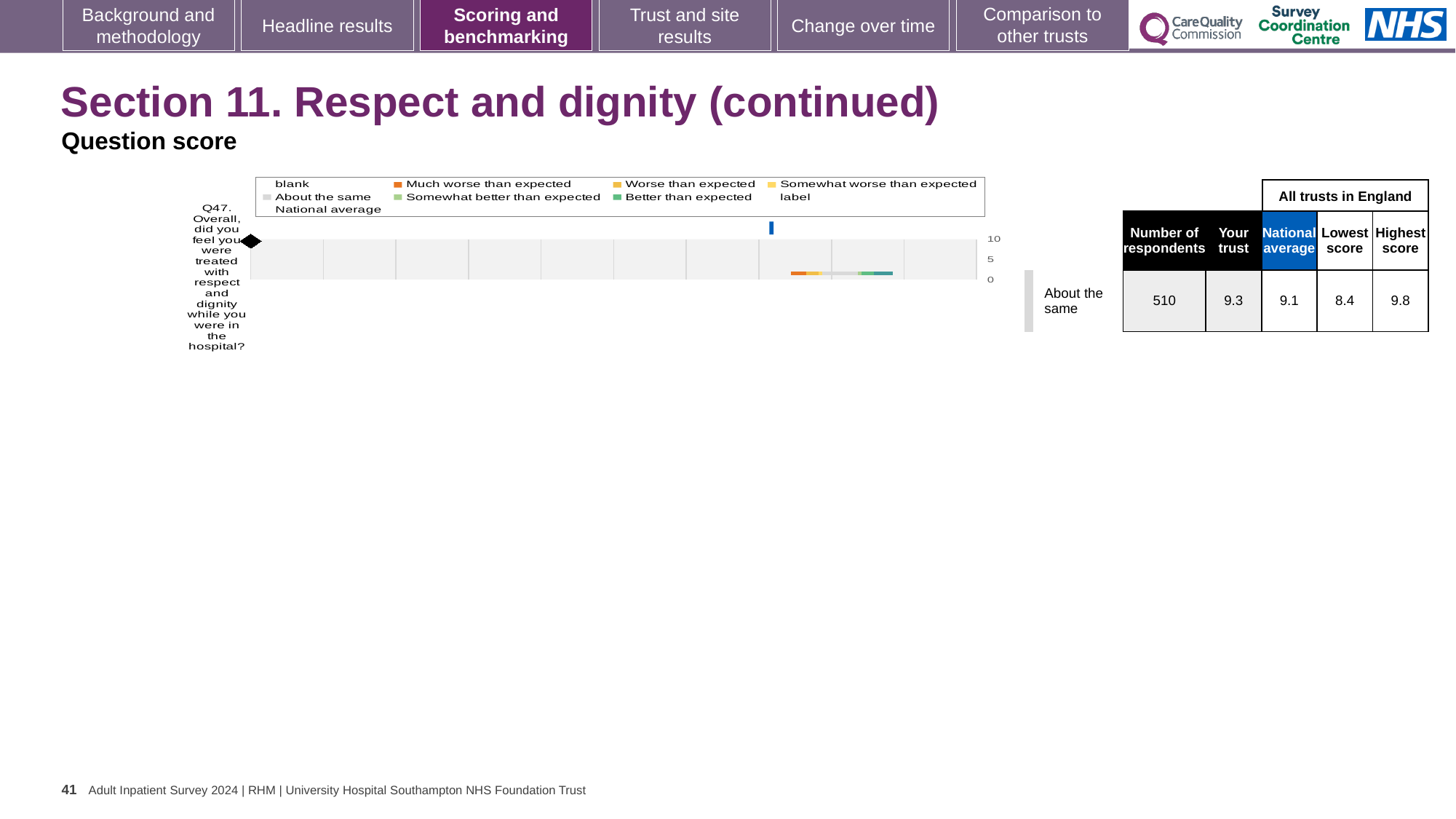
What is the highest score among all trusts in England for Q47? 9.8 How many questions (categories) are plotted on the chart? 1 What is the number of respondents for Q47? 510 What kind of chart is shown on the slide? bar chart Which is larger for Q47, the 'Your trust' score or the national average? Your trust What is the national average score for Q47? 9.1 What is the 'Your trust' score for Q47? 9.3 What is the difference between the highest score and the lowest score among all trusts in England for Q47? 1.4 Which question is plotted on the chart? Q47. Overall, did you feel you were treated with respect and dignity while you were in the hospital? Which benchmark category is the trust's result for Q47 labelled as? About the same What is the lowest score among all trusts in England for Q47? 8.4 What is the highest tick value shown on the chart's axis? 10